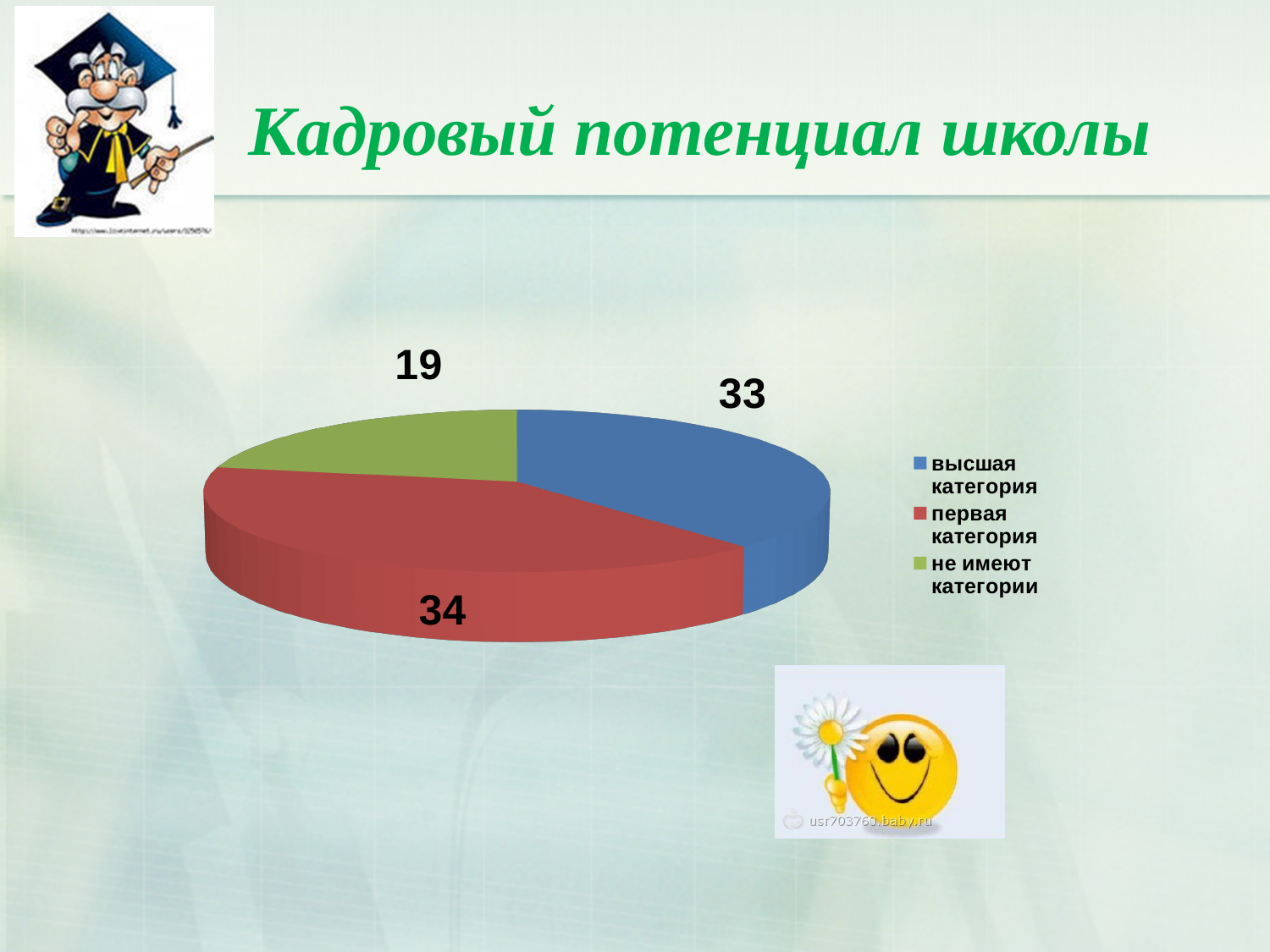
What is the difference between the values for высшая категория and не имеют категории? 14 Which is larger, the value for высшая категория or the value for не имеют категории? высшая категория Which category has the largest slice of the pie? первая категория What colour is the slice for не имеют категории? green What is the difference between the values for первая категория and не имеют категории? 15 What is the value for не имеют категории? 19 What is the value for первая категория? 34 How many categories does the pie chart have? 3 Which category has the smallest slice of the pie? не имеют категории What type of chart is shown on the slide? pie chart What is the total of all slices in the pie chart? 86 What is the value for высшая категория? 33